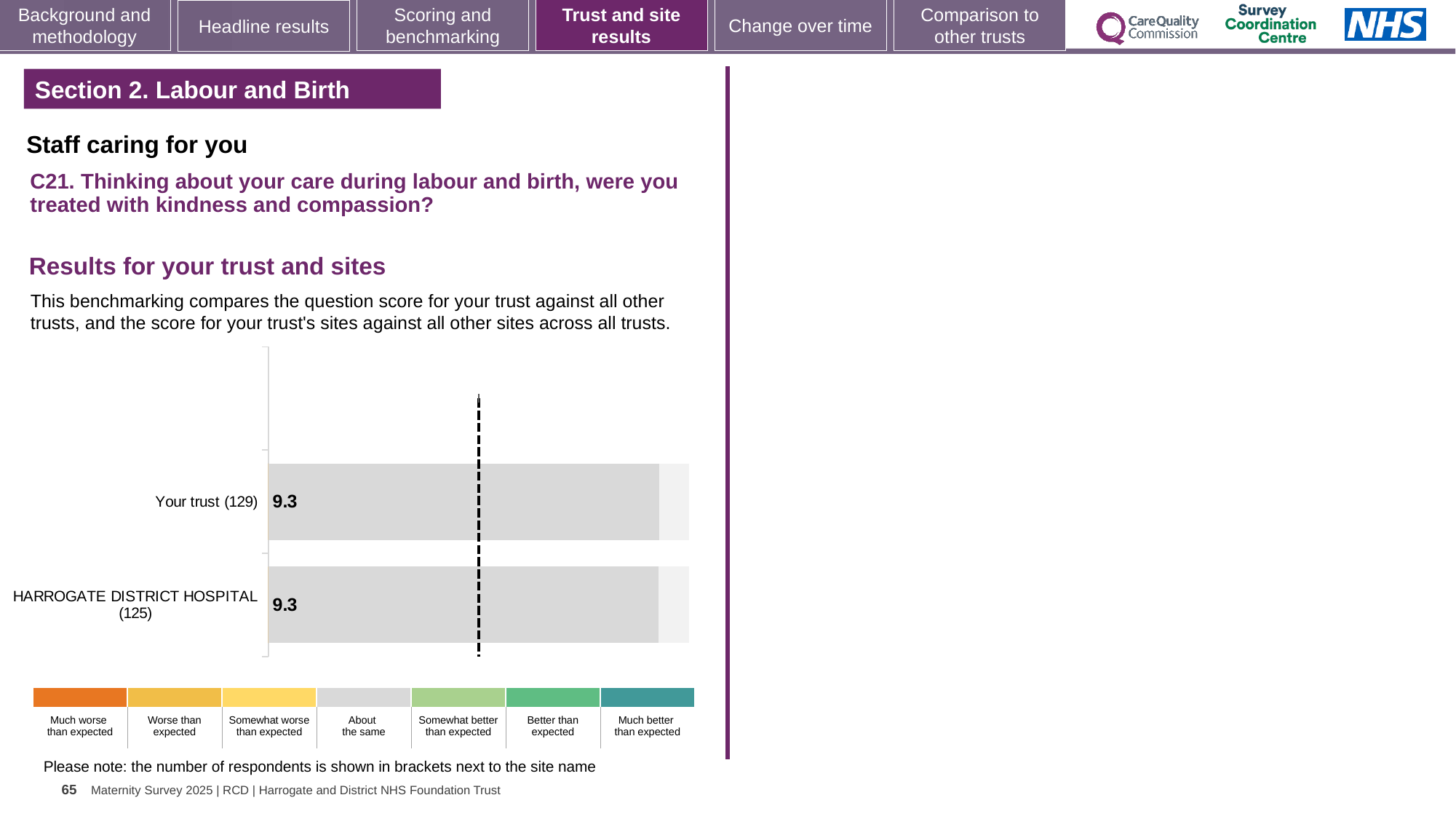
Which survey question does the chart relate to? C21. Thinking about your care during labour and birth, were you treated with kindness and compassion? How many respondents are shown in brackets for HARROGATE DISTRICT HOSPITAL? 125 Do Your trust and HARROGATE DISTRICT HOSPITAL have the same score? Yes What is the score shown for Your trust (129)? 9.3 What kind of chart is shown on the slide? Bar chart How many bars are plotted in the chart? 2 What is the difference between the score for Your trust and the score for HARROGATE DISTRICT HOSPITAL? 0 How many respondents are shown in brackets for Your trust? 129 What is the score shown for HARROGATE DISTRICT HOSPITAL (125)? 9.3